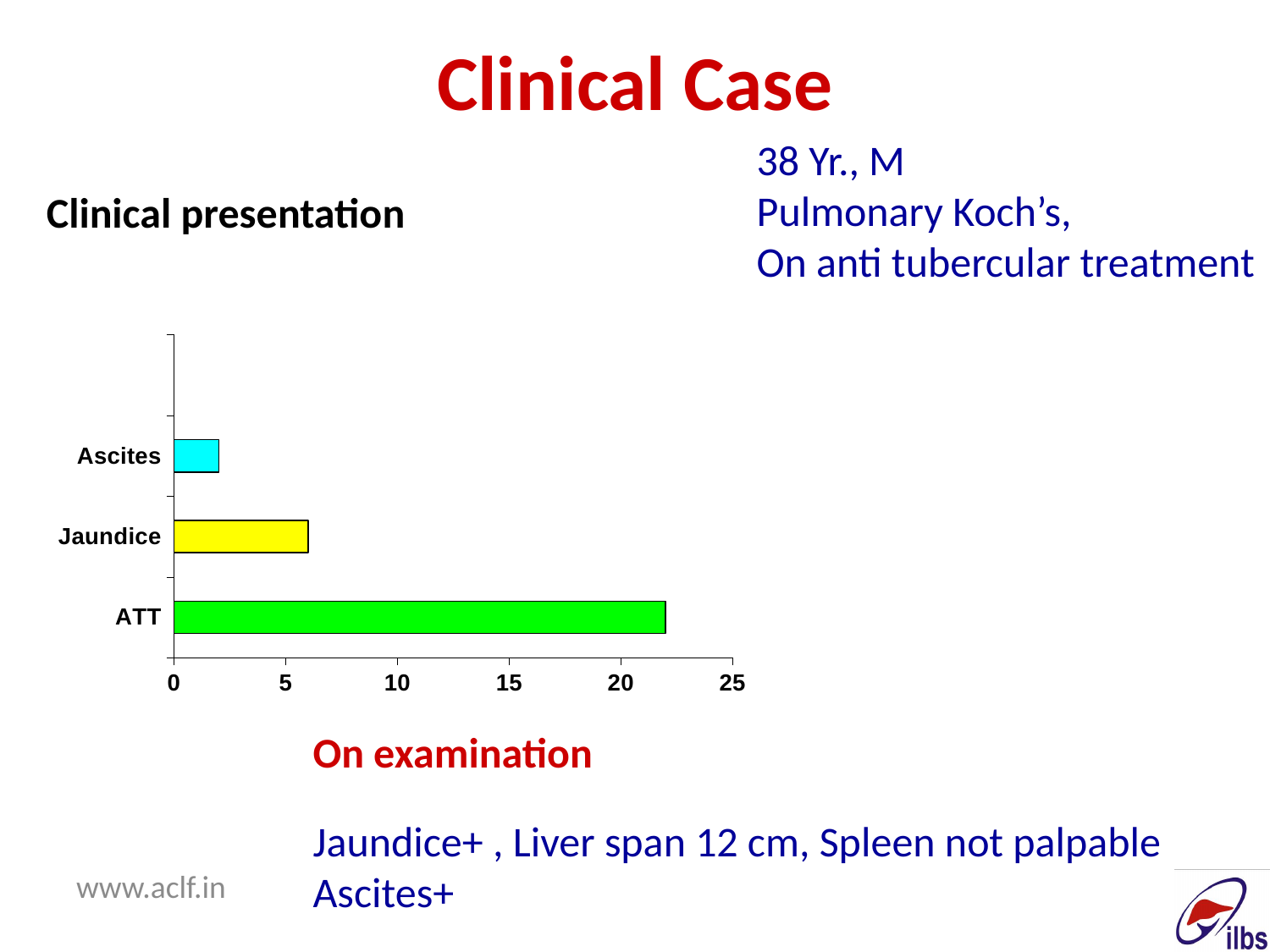
How many categories are plotted in the bar chart? 3 Is the value for Ascites greater or less than 5? less Is the value for ATT greater or less than 25? less Which category has the shortest bar in the chart? Ascites What colour is the bar for ATT? green Which category has the longest bar in the chart? ATT Is the value for ATT greater or less than 20? greater What is the maximum value shown on the horizontal axis of the chart? 25 What kind of chart is shown on the slide? bar chart Which is larger, the value for ATT or the value for Jaundice? ATT Which is larger, the value for Jaundice or the value for Ascites? Jaundice